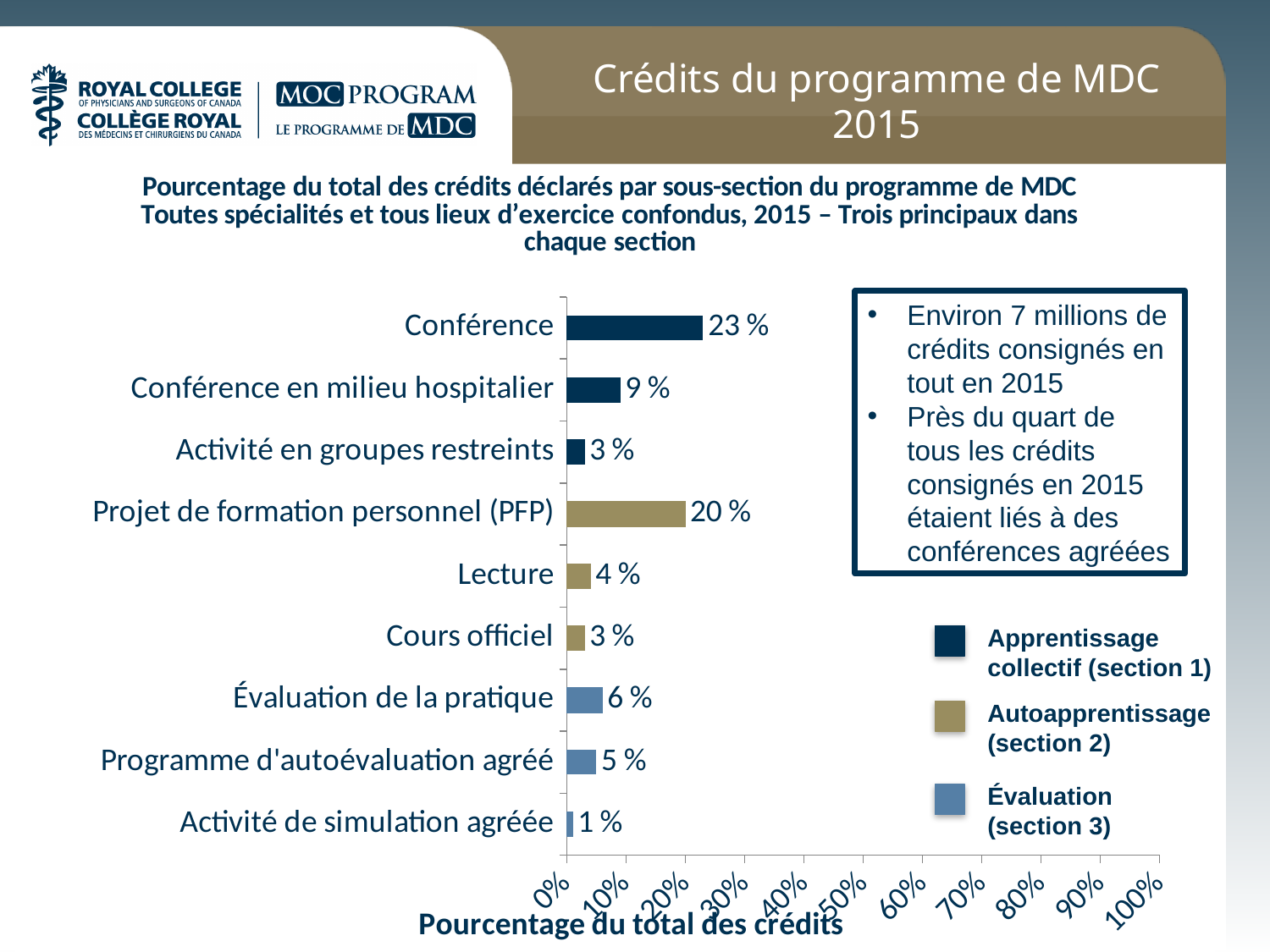
What is the label of the horizontal axis of the chart? Pourcentage du total des crédits How many categories are plotted in the chart? 9 Is the value for Projet de formation personnel (PFP) greater or less than 30%? less What is the difference between the values for Conférence and Conférence en milieu hospitalier? 14 % What percentage is shown for Programme d'autoévaluation agréé? 5 % What kind of chart is shown on the slide? Bar chart Which category has the lowest percentage of total credits? Activité de simulation agréée What value is shown for Projet de formation personnel (PFP)? 20 % Which is larger, the value for Lecture or the value for Évaluation de la pratique? Évaluation de la pratique Which category has the highest percentage of total credits? Conférence What percentage of total credits is shown for Conférence? 23 % How many sections does the legend list? 3